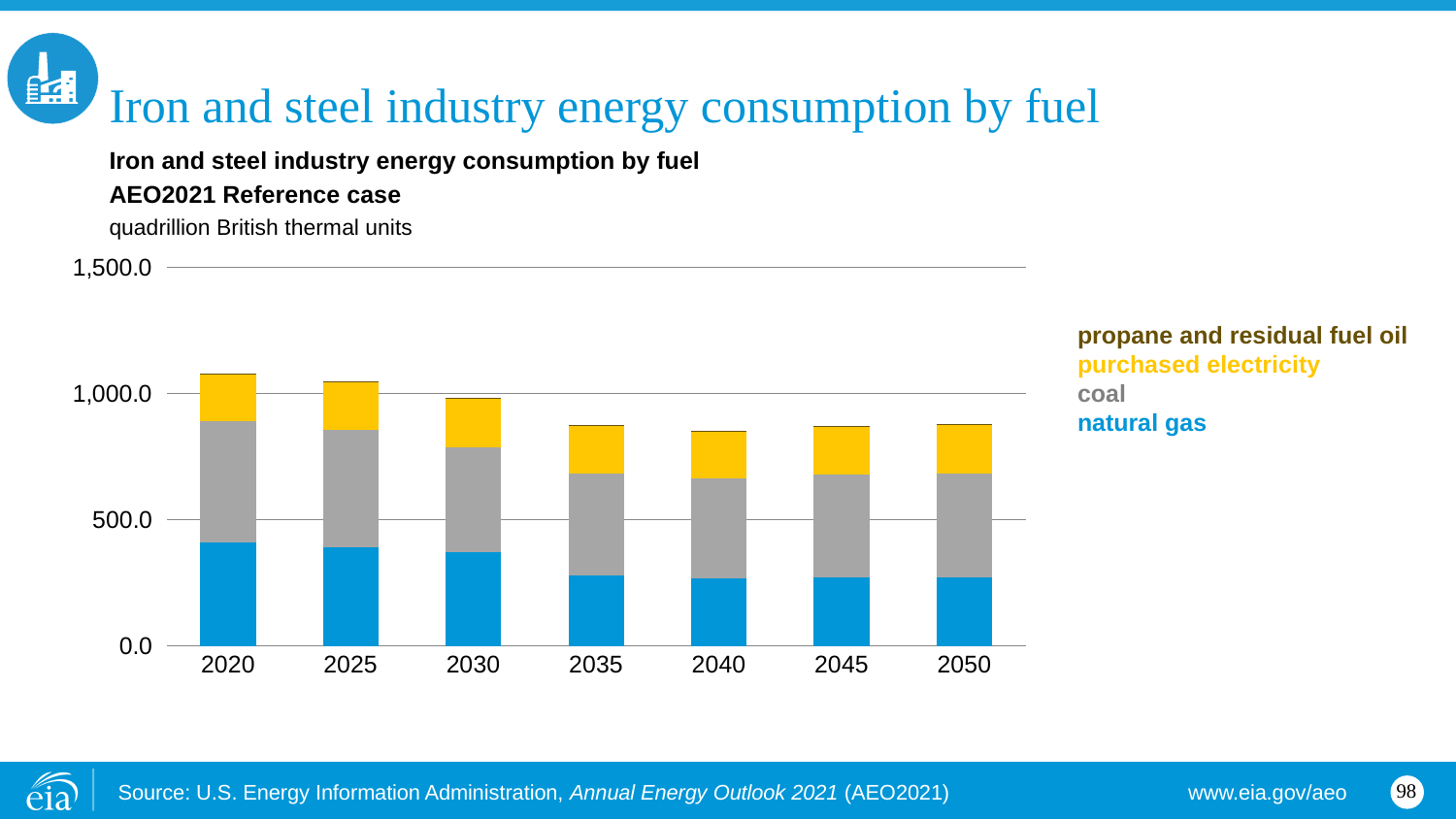
Is the natural gas value for 2020 greater or less than 500.0? less Is the total energy consumption for 2020 greater or less than 1,000.0? greater Which is larger, the total energy consumption in 2020 or in 2050? 2020 Is the total energy consumption for 2040 greater or less than 1,000.0? less How many years are shown on the x axis of the chart? 7 Which year has the highest total energy consumption? 2020 Which fuel is shown in blue at the bottom of each bar? natural gas How many fuel series does the legend list? 4 Does total energy consumption rise or fall from 2020 to 2040? fall What unit is the chart's y axis measured in? quadrillion British thermal units What kind of chart is shown on the slide? stacked bar chart